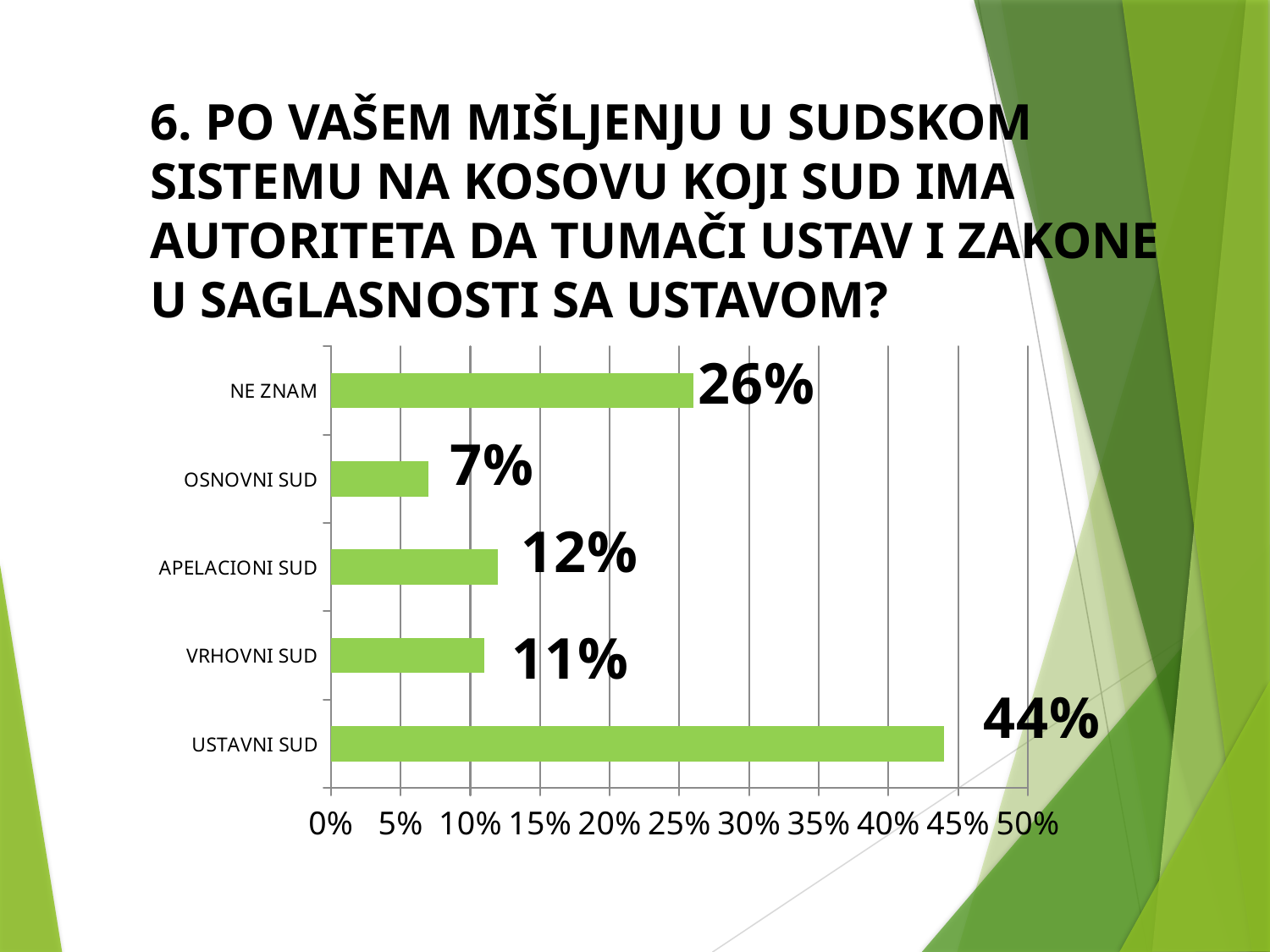
What is the value for USTAVNI SUD? 44% Which category has the highest value? USTAVNI SUD What is the maximum value shown on the x axis? 50% Which is larger, the value for APELACIONI SUD or the value for VRHOVNI SUD? APELACIONI SUD Is the value for USTAVNI SUD greater or less than 40%? greater What is the value for OSNOVNI SUD? 7% How many categories are shown in the chart? 5 Which category has the lowest value? OSNOVNI SUD What is the difference between the values for USTAVNI SUD and NE ZNAM? 18% What is the value for NE ZNAM? 26% What kind of chart is shown on the slide? bar chart What is the value for APELACIONI SUD? 12%